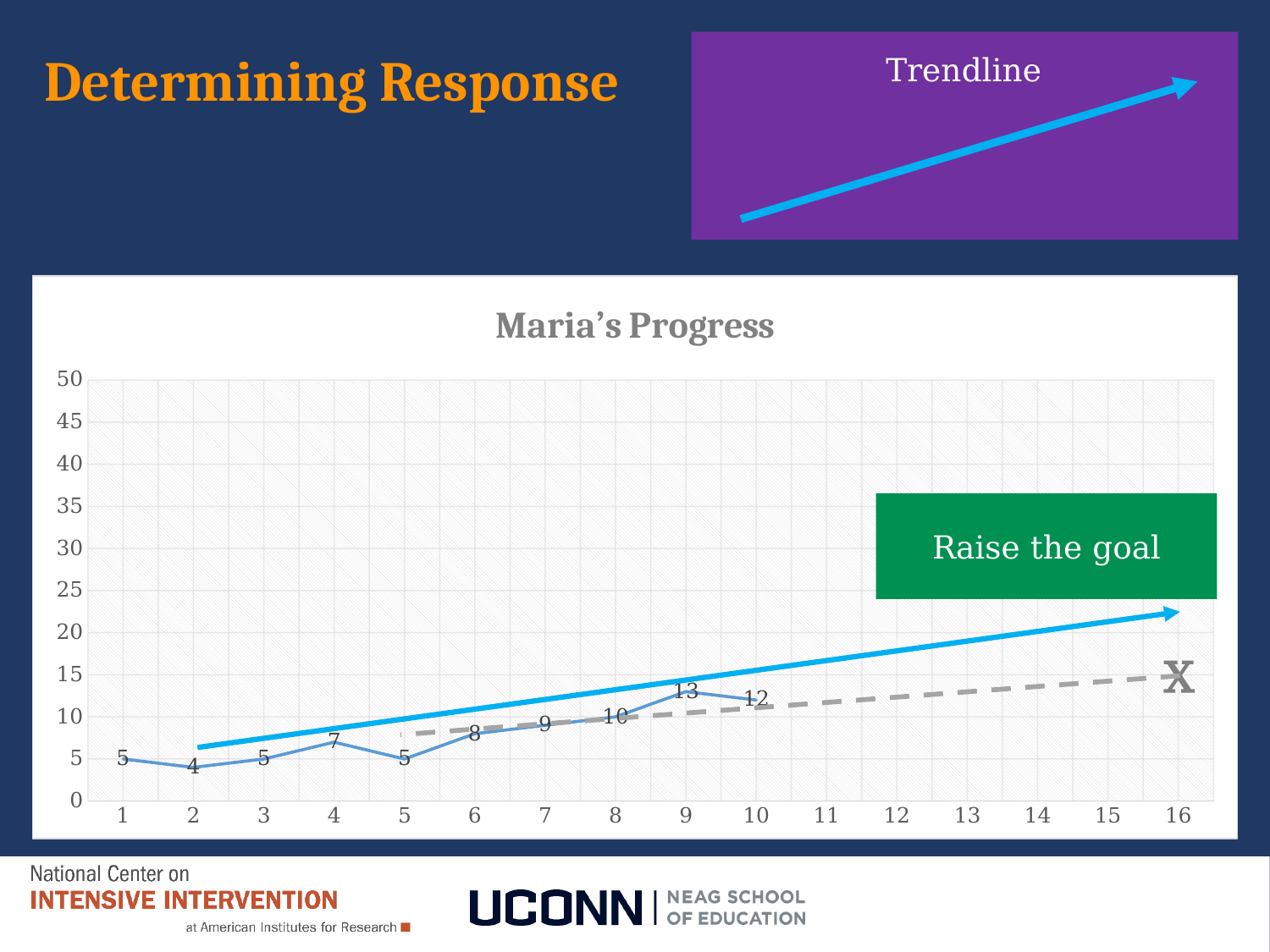
What is the value plotted at point 2? 4 What type of chart is shown on the slide? line chart What is the value plotted at point 10? 12 Which is larger, the value at point 6 or the value at point 8? point 8 Which point has the highest plotted value? 9 Which point has the lowest plotted value? 2 What is the title of the chart? Maria's Progress What is the value plotted at point 1? 5 What is the value plotted at point 9? 13 Overall, do the plotted values rise or fall from point 1 to point 10? rise What is the difference between the values at point 9 and point 1? 8 What is the value plotted at point 4? 7